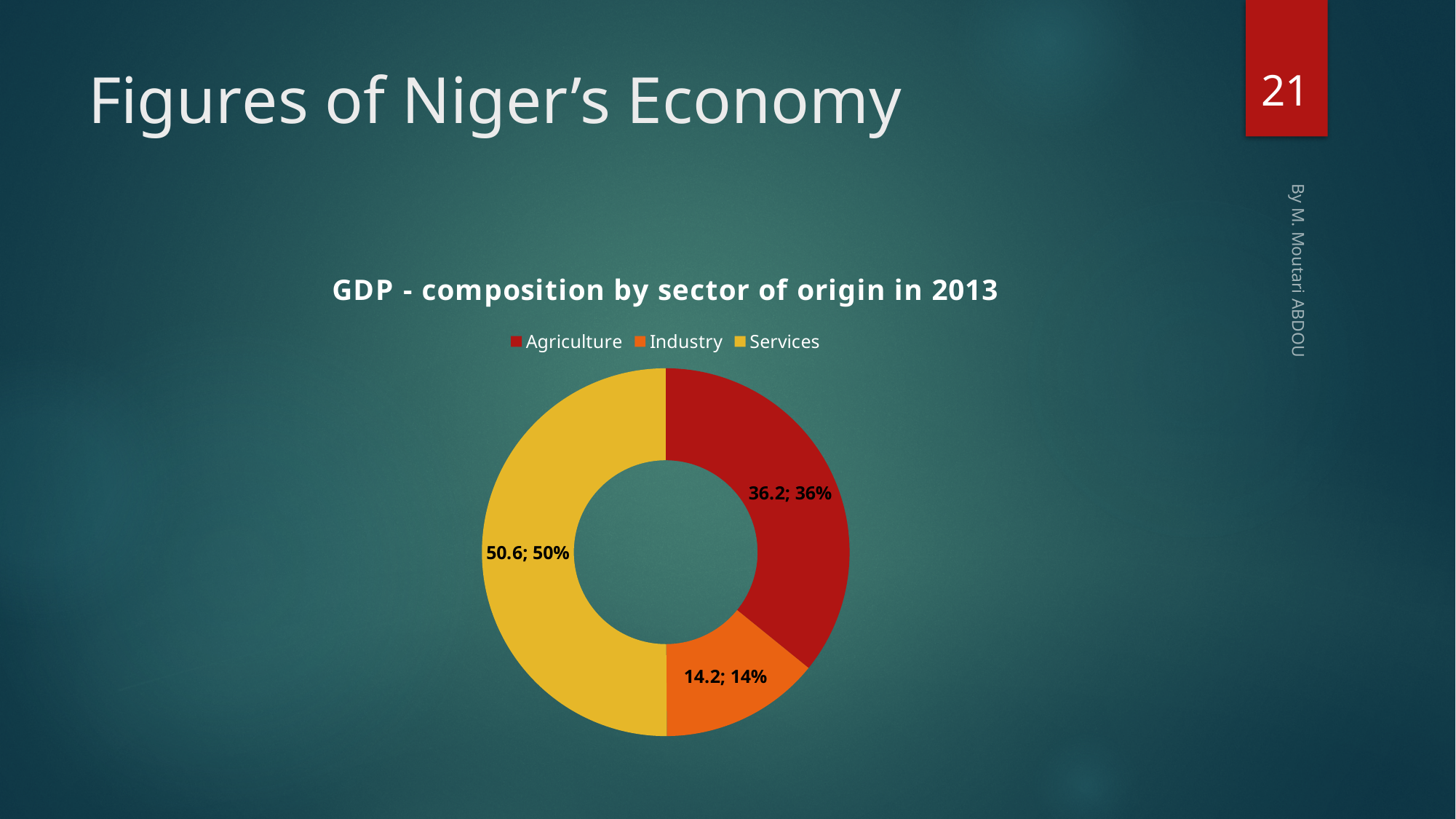
Which sector has the largest share of GDP? Services Which is larger, Agriculture or Industry? Agriculture How many sectors are shown in the chart? 3 What percentage share of the chart does Industry represent? 14% What is the difference between the values for Services and Agriculture? 14.4 What is the title of the chart? GDP - composition by sector of origin in 2013 What is the value for Agriculture? 36.2 What is the difference between the values for Agriculture and Industry? 22 What percentage share of the chart does Services represent? 50% Which sector has the smallest share of GDP? Industry What is the value for Services? 50.6 What is the value for Industry? 14.2